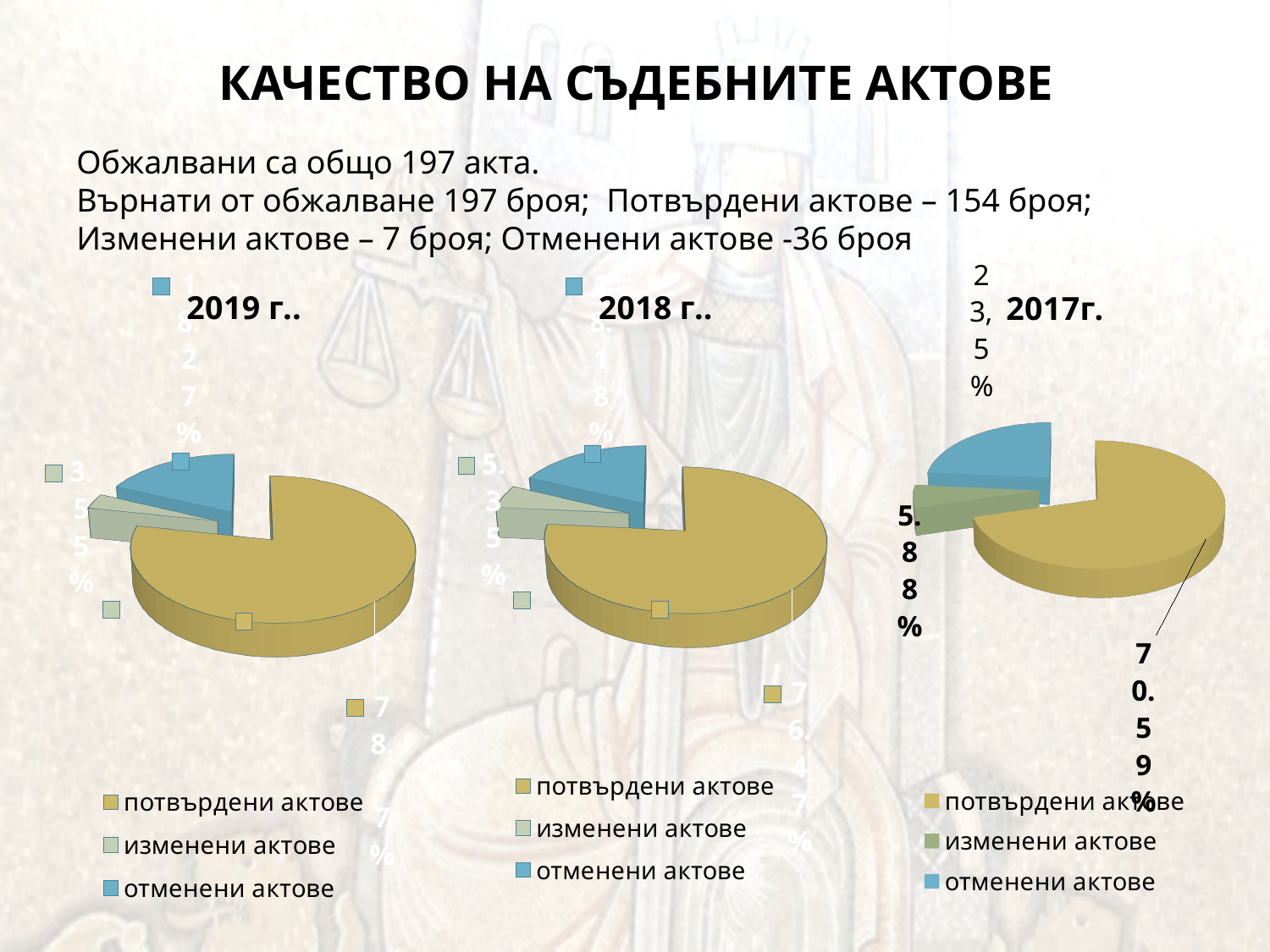
In the 2017г. chart, which category has the smallest slice? изменени актове What is the title of the slide containing the three pie charts? КАЧЕСТВО НА СЪДЕБНИТЕ АКТОВЕ In the 2019 г.. chart, which slice is larger: отменени актове or изменени актове? отменени актове In the 2018 г.. chart, which category has the largest slice? потвърдени актове What kind of chart is used for the 2019 г.. data on the slide? pie chart In the 2019 г.. chart, what is the share shown for изменени актове? 3.55% How many pie charts are shown on the slide? 3 How many entries does the legend of the 2017г. chart list? 3 In the 2017г. chart, what is the share shown for изменени актове? 5.88% In the 2017г. chart, which category has the largest slice? потвърдени актове In the 2017г. chart, what is the share shown for потвърдени актове? 70.59% In the 2018 г.. chart, what is the share shown for потвърдени актове? 76.47%